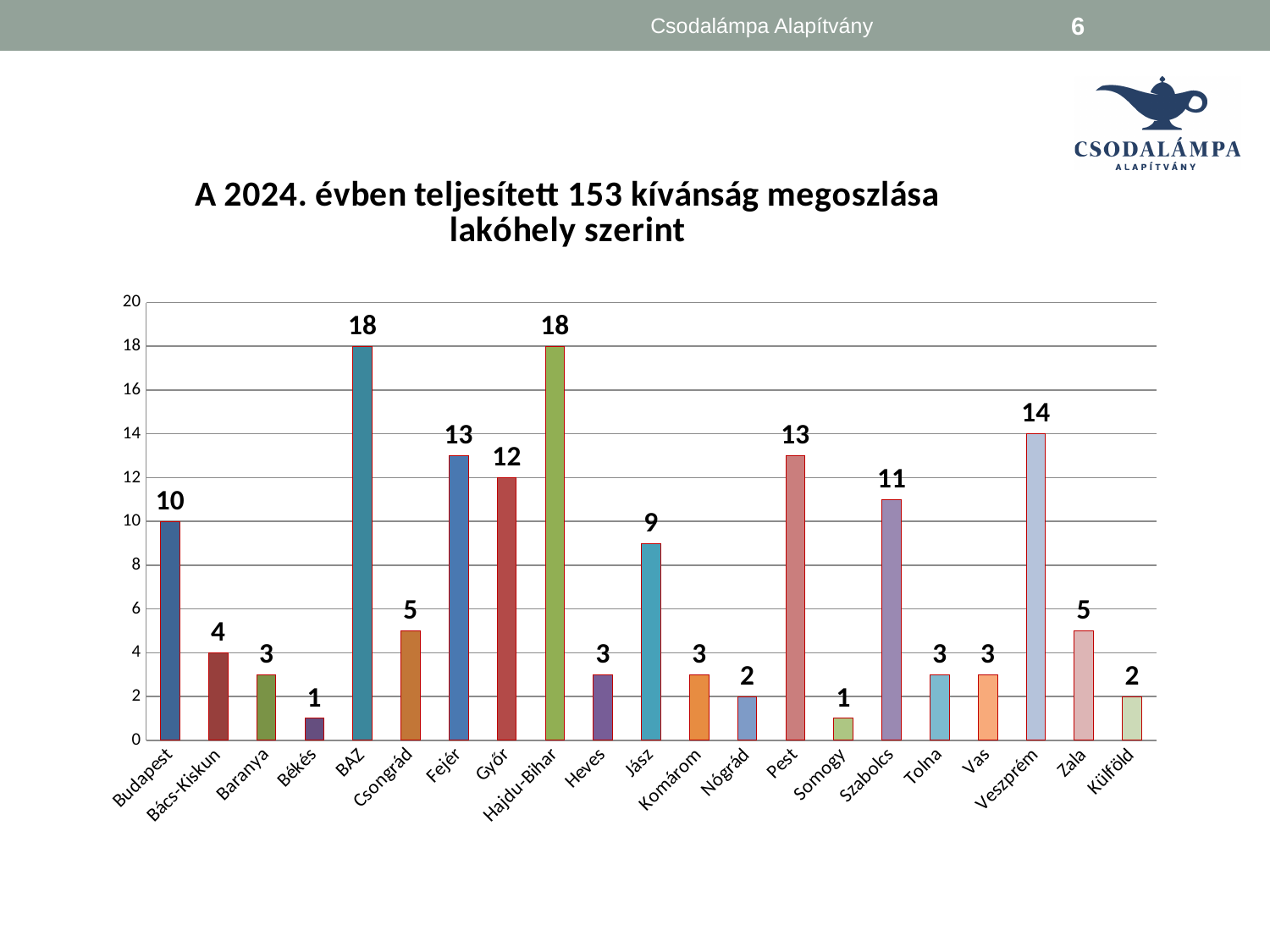
What is the difference between the values for Fejér and Győr? 1 What is the difference between the values for Veszprém and Jász? 5 What is the value for Szabolcs? 11 Which is larger, the value for Pest or the value for Szabolcs? Pest What is the value for Külföld? 2 What is the value for Veszprém? 14 Which two categories share the highest value? BAZ and Hajdu-Bihar Which two categories share the lowest value? Békés and Somogy What kind of chart is shown on the slide? Bar chart What is the title of the chart? A 2024. évben teljesített 153 kívánság megoszlása lakóhely szerint How many categories are shown on the x axis? 21 What is the value for Budapest? 10